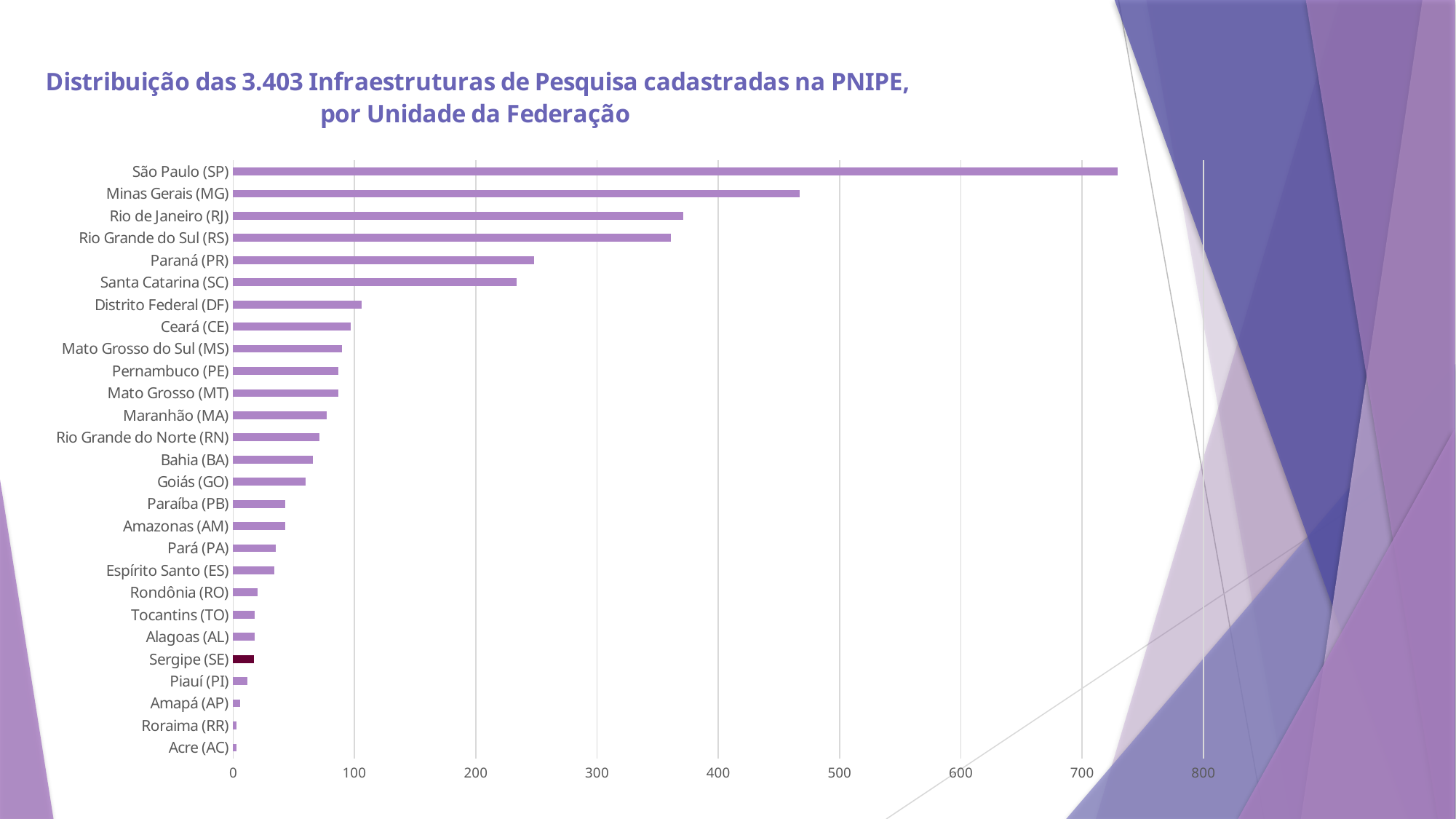
Is the value for Minas Gerais (MG) greater or less than 400? greater What kind of chart is shown on the slide? bar chart Which state's bar is drawn in a different (dark) colour from the others? Sergipe (SE) Which state has the highest number of research infrastructures on the chart? São Paulo (SP) Is the value for Rio de Janeiro (RJ) greater or less than 300? greater Is the value for Bahia (BA) greater or less than 100? less Which has a larger value, Minas Gerais (MG) or Rio de Janeiro (RJ)? Minas Gerais (MG) How many states (units of the federation) are listed on the chart? 27 According to the chart title, how many research infrastructures are registered in the PNIPE? 3.403 Which has a larger value, Paraná (PR) or Santa Catarina (SC)? Paraná (PR)